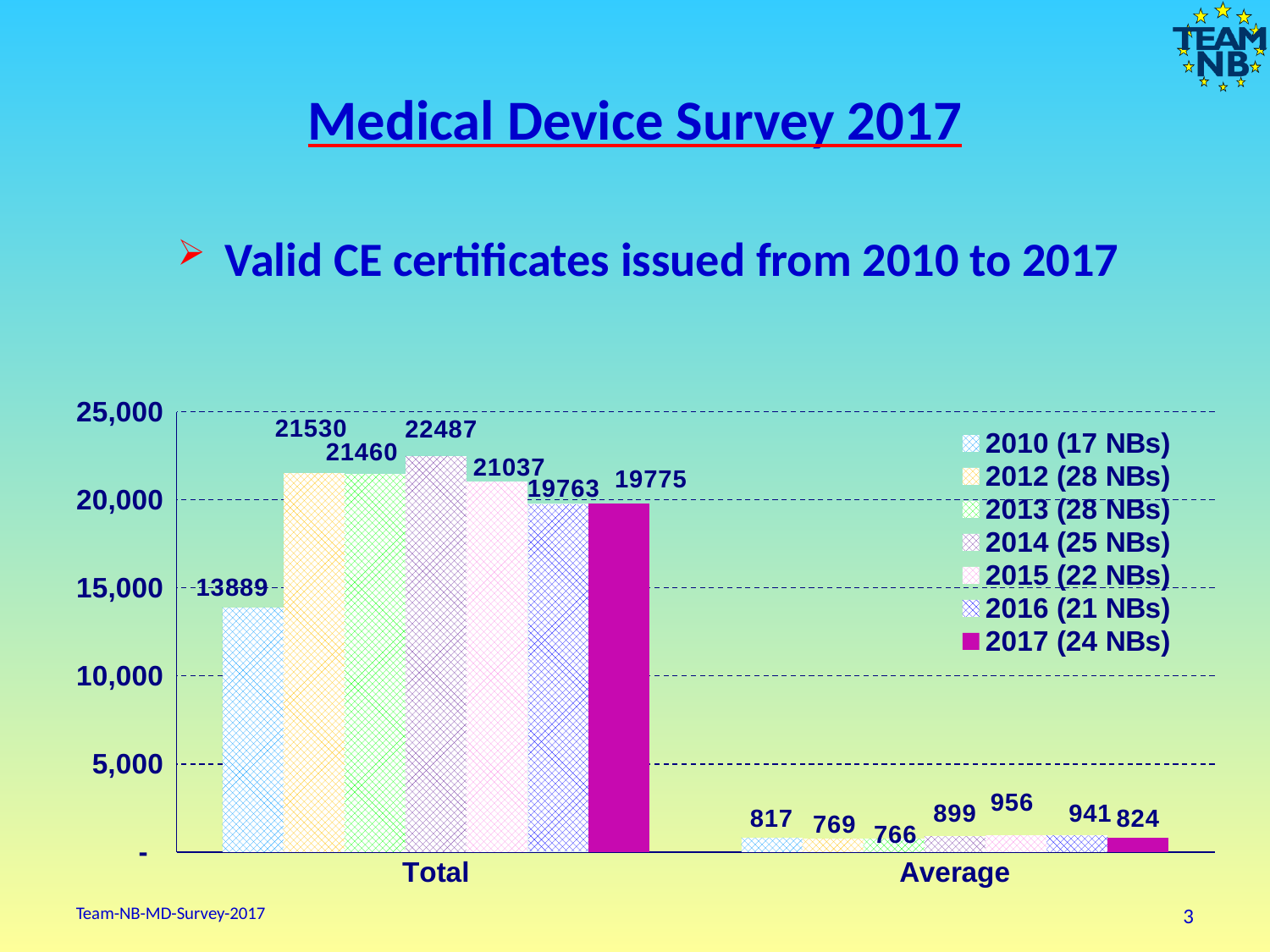
What kind of chart is shown on the slide? bar chart Is the Total value for 2016 (21 NBs) greater or less than 20,000? less Which is larger, the Total value for 2012 (28 NBs) or for 2013 (28 NBs)? 2012 (28 NBs) Which year has the lowest Average value? 2013 (28 NBs) Which year has the lowest Total value? 2010 (17 NBs) What is the Average value for 2015 (22 NBs)? 956 What is the difference between the Total values for 2014 (25 NBs) and 2010 (17 NBs)? 8598 What is the Total value for 2017 (24 NBs)? 19775 What is the Average value for 2013 (28 NBs)? 766 What is the Total value for 2010 (17 NBs)? 13889 How many series does the legend list? 7 Which year has the highest Total value? 2014 (25 NBs)